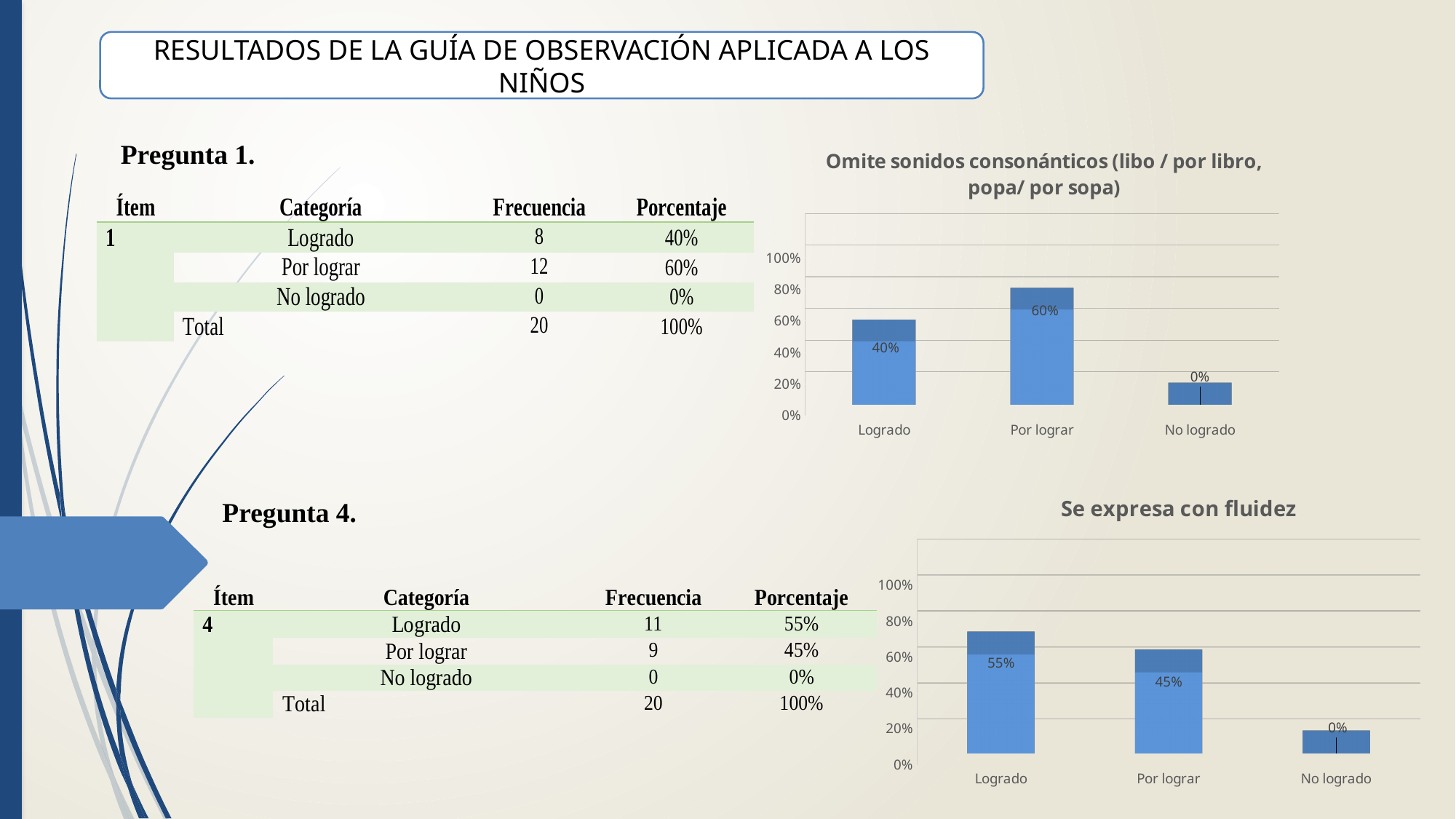
In the chart titled "Omite sonidos consonánticos", what is the value for Por lograr? 60% In the chart titled "Omite sonidos consonánticos", which category has the highest value? Por lograr In the chart titled "Se expresa con fluidez", what is the value for Logrado? 55% In the chart titled "Se expresa con fluidez", what is the value for No logrado? 0% In the chart titled "Omite sonidos consonánticos", what is the value for Logrado? 40% In the chart titled "Omite sonidos consonánticos", which category has the lowest value? No logrado In the chart titled "Omite sonidos consonánticos", how many categories are shown on the x axis? 3 In the chart titled "Se expresa con fluidez", do the values rise or fall from Logrado to No logrado along the x axis? Fall In the chart titled "Se expresa con fluidez", which is larger, Logrado or Por lograr? Logrado In the chart titled "Se expresa con fluidez", what is the difference between Logrado and Por lograr? 10% In the chart titled "Omite sonidos consonánticos", what is the difference between Por lograr and Logrado? 20% What kind of chart is "Se expresa con fluidez"? Bar chart